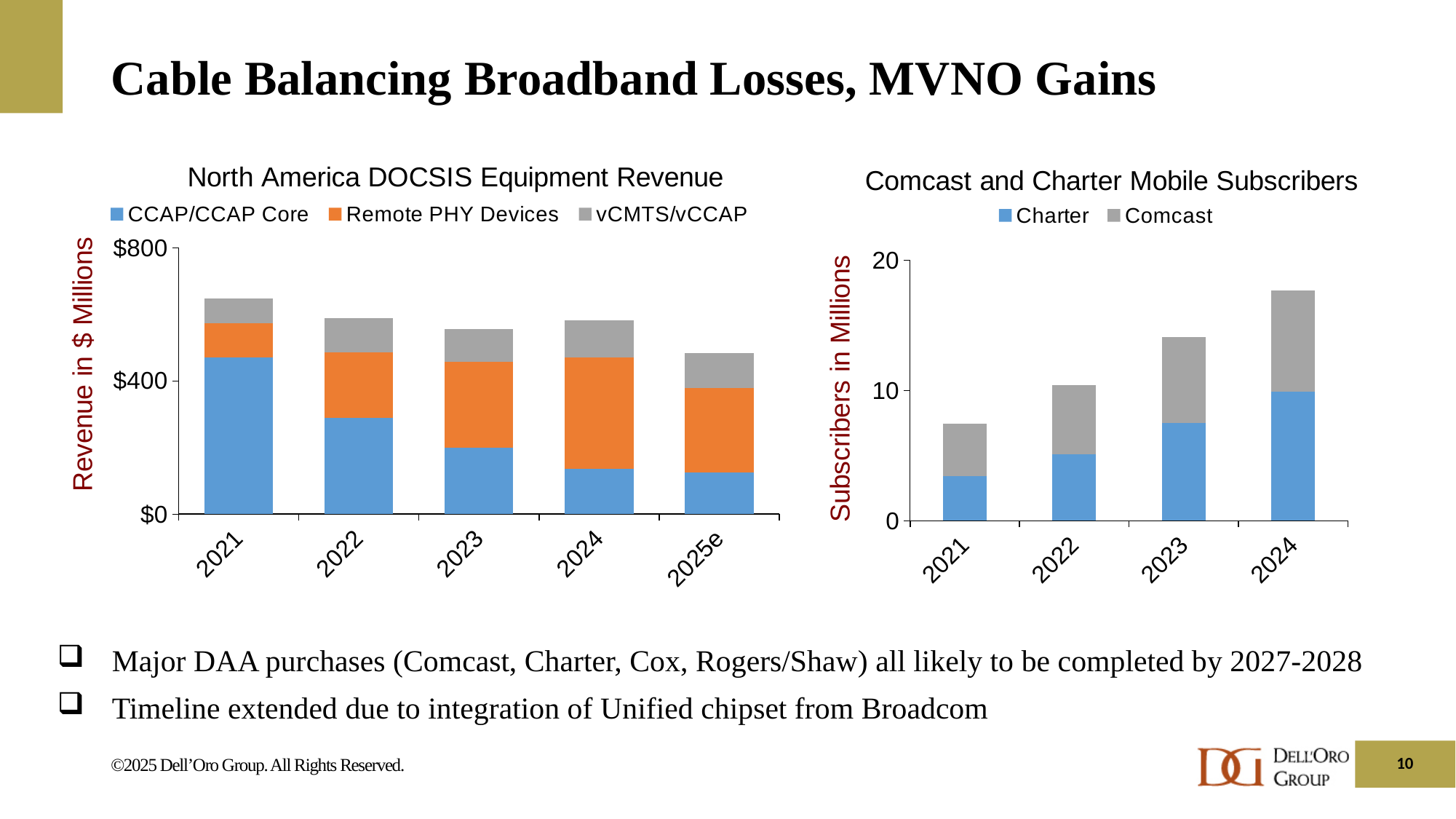
In the Comcast and Charter Mobile Subscribers chart, is the total stacked bar for 2021 greater or less than 10? less How many years are shown on the x axis of the North America DOCSIS Equipment Revenue chart? 5 What kind of chart is the North America DOCSIS Equipment Revenue chart? stacked bar chart In the North America DOCSIS Equipment Revenue chart, is the Remote PHY Devices segment larger in 2021 or in 2024? 2024 How many series does the legend of the North America DOCSIS Equipment Revenue chart list? 3 What is the y-axis label of the Comcast and Charter Mobile Subscribers chart? Subscribers in Millions How many series does the legend of the Comcast and Charter Mobile Subscribers chart list? 2 In the North America DOCSIS Equipment Revenue chart, is the CCAP/CCAP Core value for 2022 greater or less than $400? less In the North America DOCSIS Equipment Revenue chart, which year has the lowest total stacked bar? 2025e In the Comcast and Charter Mobile Subscribers chart, do the total subscribers rise or fall from 2021 to 2024? rise In the North America DOCSIS Equipment Revenue chart, is the CCAP/CCAP Core value for 2021 greater or less than $400? greater In the North America DOCSIS Equipment Revenue chart, which year has the highest total stacked bar? 2021